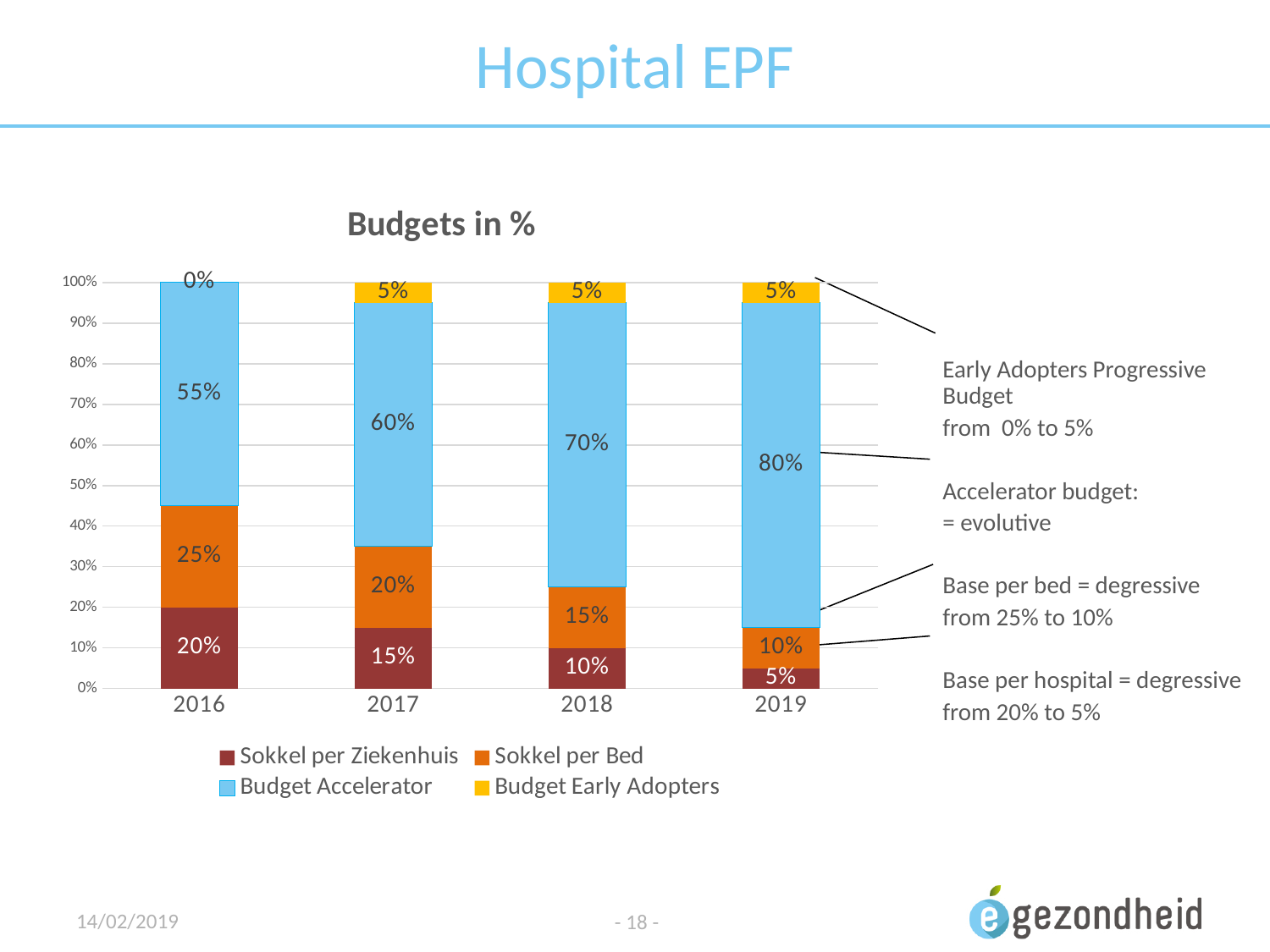
What kind of chart is shown on the slide? Stacked bar chart What is the title of the chart? Budgets in % What is the difference between Budget Accelerator in 2019 and in 2016? 25% What is the value for Budget Accelerator in 2018? 70% In which year is Sokkel per Bed lowest? 2019 What is the value for Budget Early Adopters in 2016? 0% Which is larger in 2017: Sokkel per Bed or Sokkel per Ziekenhuis? Sokkel per Bed Does Sokkel per Ziekenhuis rise or fall from 2016 to 2019? Fall What is the value for Sokkel per Ziekenhuis in 2017? 15% How many years are shown on the x axis? 4 How many series does the legend list? 4 In which year is Budget Accelerator highest? 2019